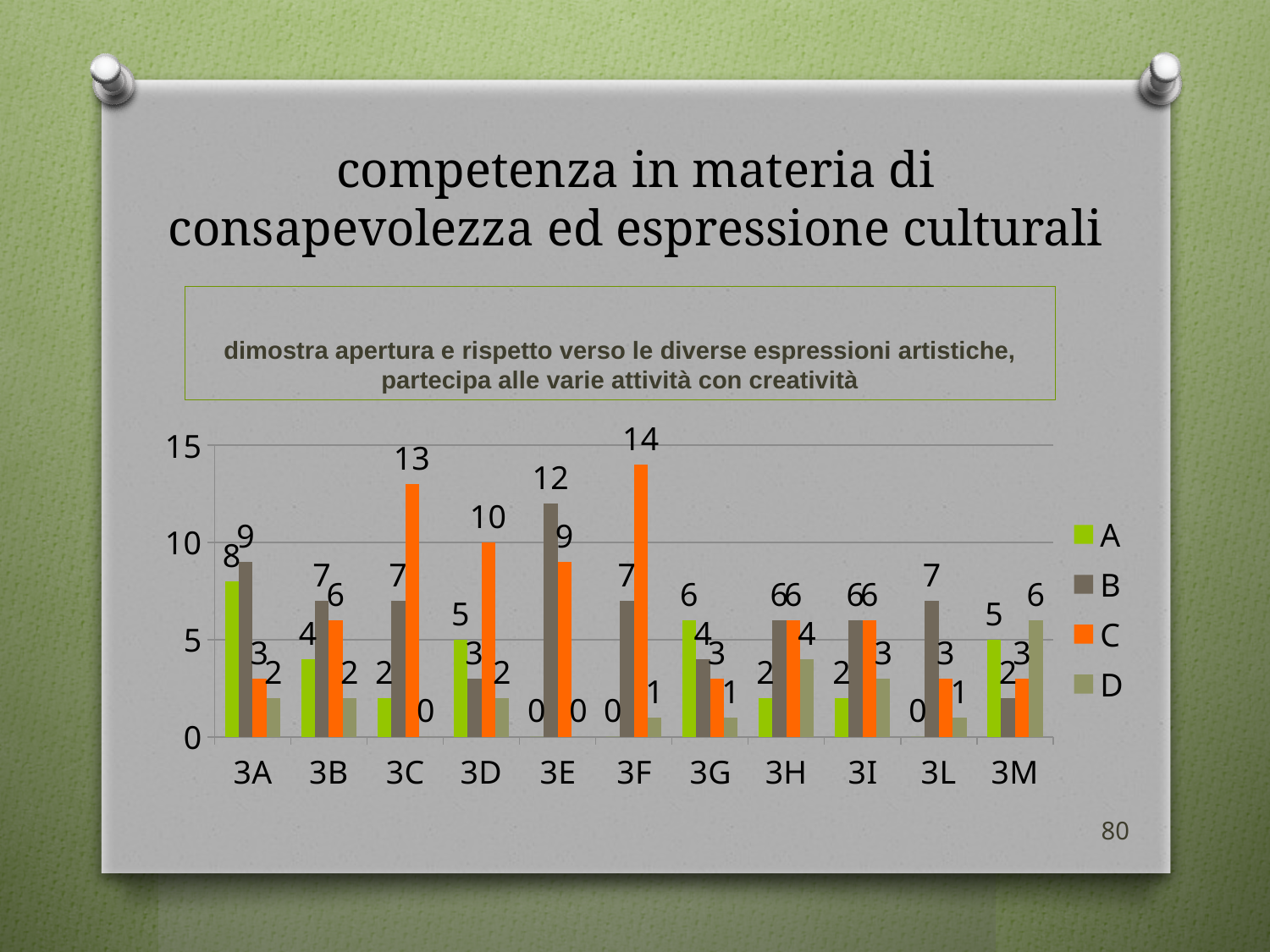
What is the difference between series C and series A for class 3C? 11 For class 3A, which is larger: series A or series B? B How many classes are shown on the x axis? 11 What is the value of series D for class 3M? 6 Which class has the highest value for series C? 3F How many series does the legend list? 4 What is the difference between series C and series B for class 3F? 7 What is the value of series C for class 3C? 13 What is the value of series B for class 3E? 12 Which class has the lowest value for series B? 3M What is the value of series A for class 3G? 6 Which class has the highest value for series A? 3A